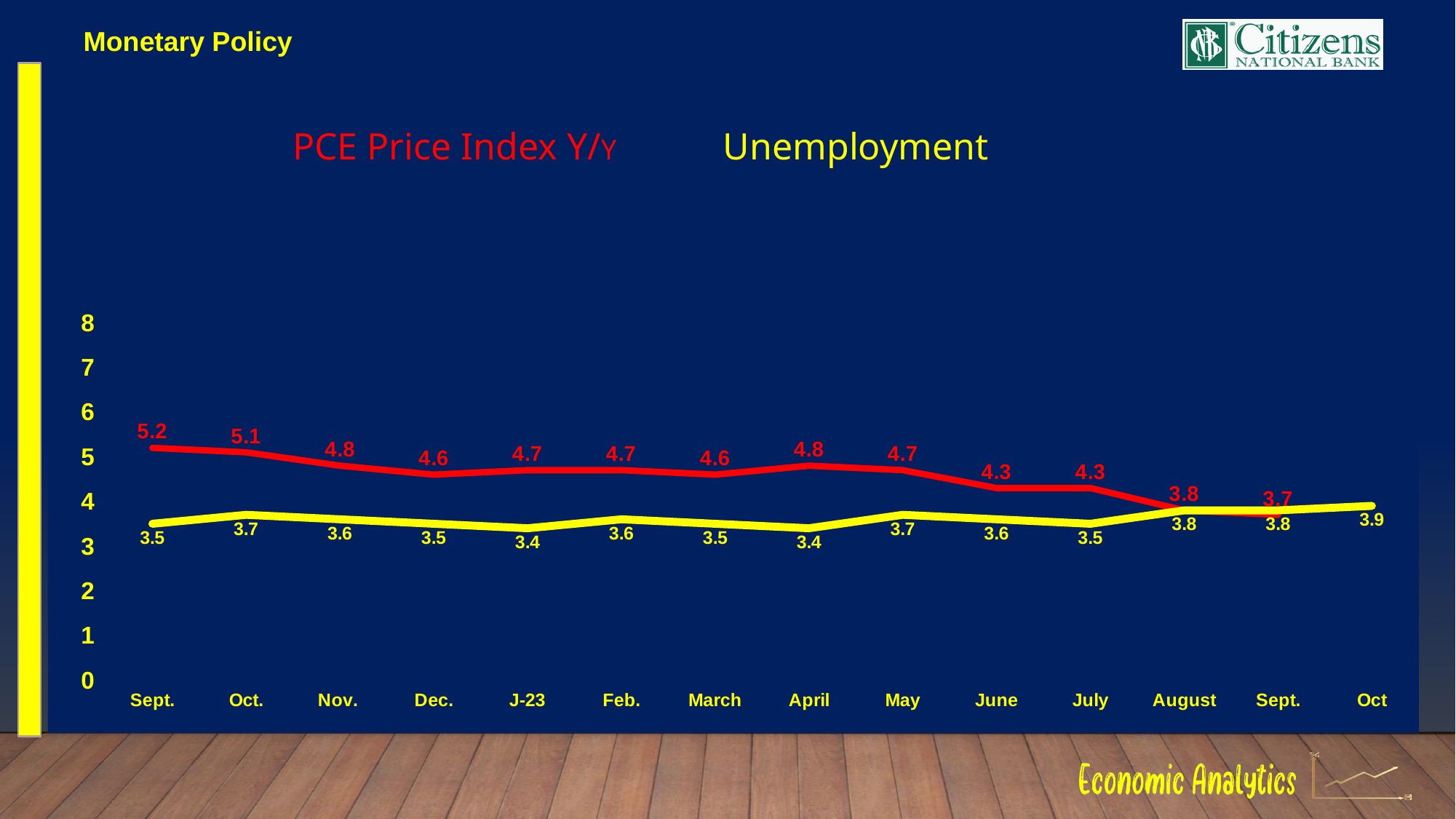
What is the Unemployment value for J-23? 3.4 In May, which is larger: PCE Price Index Y/Y or Unemployment? PCE Price Index Y/Y What kind of chart is shown on the slide? line chart What is the PCE Price Index Y/Y value for August? 3.8 How many series does the chart show? 2 How many months are plotted along the x axis? 14 In which month is Unemployment highest? Oct In which month is the PCE Price Index Y/Y highest? Sept. (the first one) What is the difference between the PCE Price Index Y/Y and Unemployment in April? 1.4 What colour is the Unemployment line? yellow Does the PCE Price Index Y/Y generally rise or fall from the first Sept. to the second Sept.? fall What is the PCE Price Index Y/Y value for the first Sept. on the x axis? 5.2